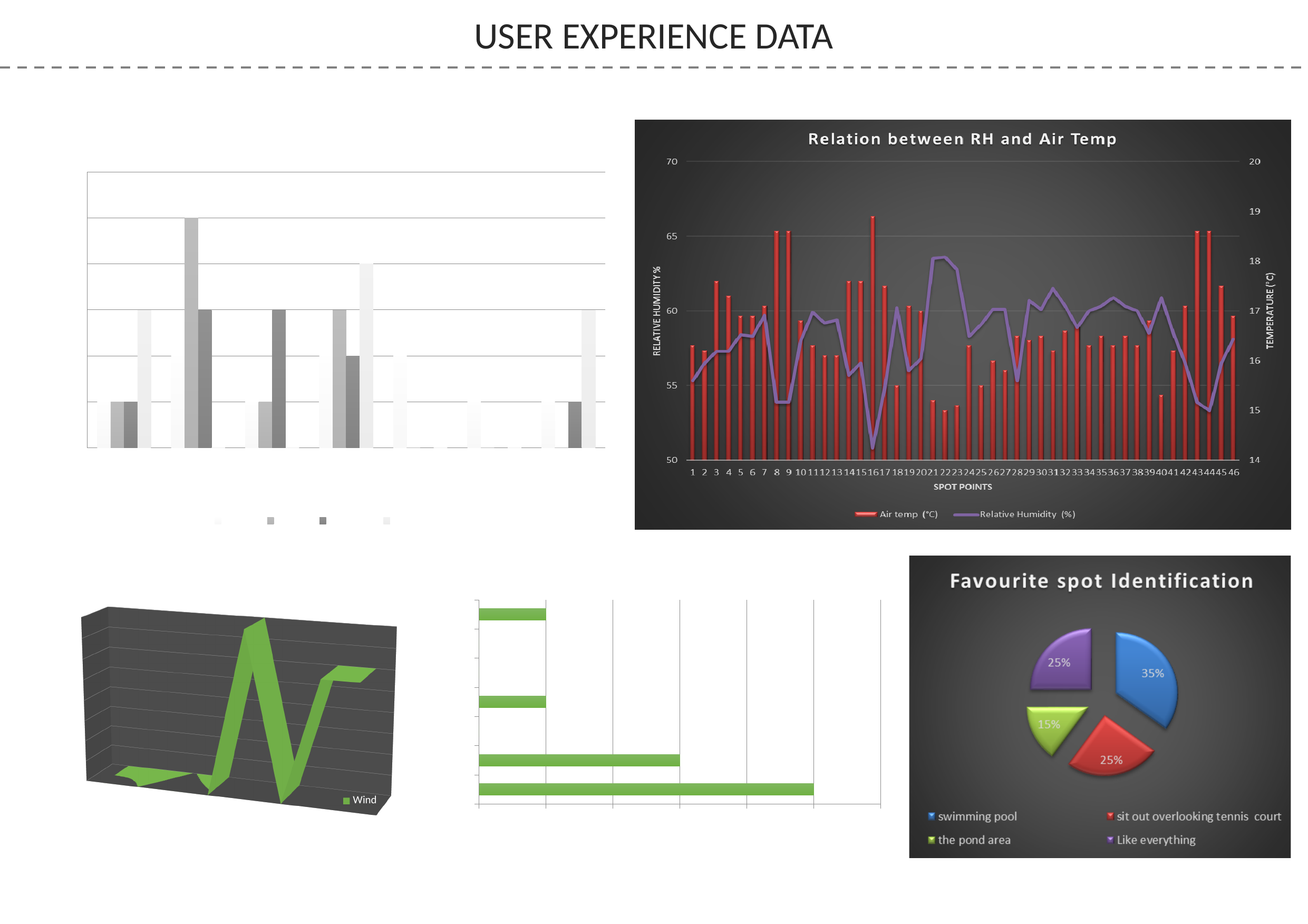
How many spot points are shown on the x axis of the 'Relation between RH and Air Temp' chart? 46 How many categories does the 'Favourite spot Identification' pie chart show? 4 In the 'Relation between RH and Air Temp' chart, is the Relative Humidity value at spot point 16 greater or less than 55? less How many series does the legend of the 'Relation between RH and Air Temp' chart list? 2 In the 'Favourite spot Identification' pie chart, what share is shown for the pond area? 15% In the 'Favourite spot Identification' pie chart, what is the difference between the swimming pool share and the pond area share? 20% In the 'Favourite spot Identification' pie chart, which category has the smallest share? the pond area In the 'Relation between RH and Air Temp' chart, at which spot point is the Air temp bar highest? 16 What kind of chart is the bottom-left chart with the 'Wind' legend? line chart In the 'Favourite spot Identification' pie chart, what share is shown for swimming pool? 35% In the 'Favourite spot Identification' pie chart, which category has the largest share? swimming pool In the 'Relation between RH and Air Temp' chart, is the Air temp value at spot point 16 greater or less than 18? greater